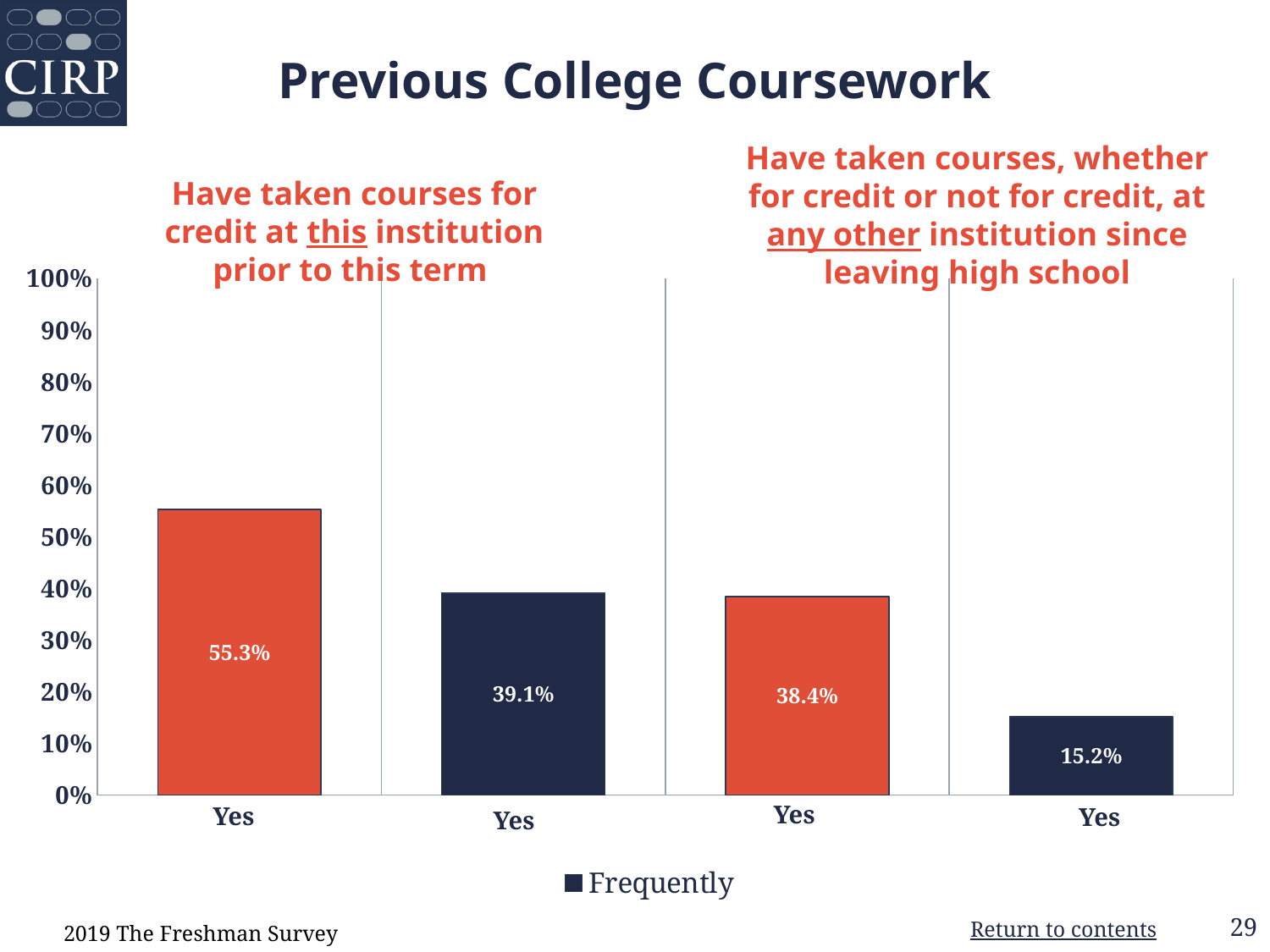
How many bars are plotted on the chart? 4 What is the title of the slide? Previous College Coursework What kind of chart is shown on the slide? bar chart What is the value of the dark blue bar under "Have taken courses for credit at this institution prior to this term"? 39.1% What is the difference between the orange and dark blue bars for courses taken for credit at this institution prior to this term? 16.2% What is the value of the orange bar under "Have taken courses, whether for credit or not for credit, at any other institution since leaving high school"? 38.4% What is the lowest value shown on the chart? 15.2% Which is larger: the dark blue bar for this institution (39.1%) or the orange bar for any other institution (38.4%)? the dark blue bar for this institution (39.1%) What is the value of the dark blue bar under "Have taken courses, whether for credit or not for credit, at any other institution since leaving high school"? 15.2% What is the value of the orange bar under "Have taken courses for credit at this institution prior to this term"? 55.3% What is the difference between the orange and dark blue bars for courses taken at any other institution since leaving high school? 23.2% What is the highest value shown on the chart? 55.3%